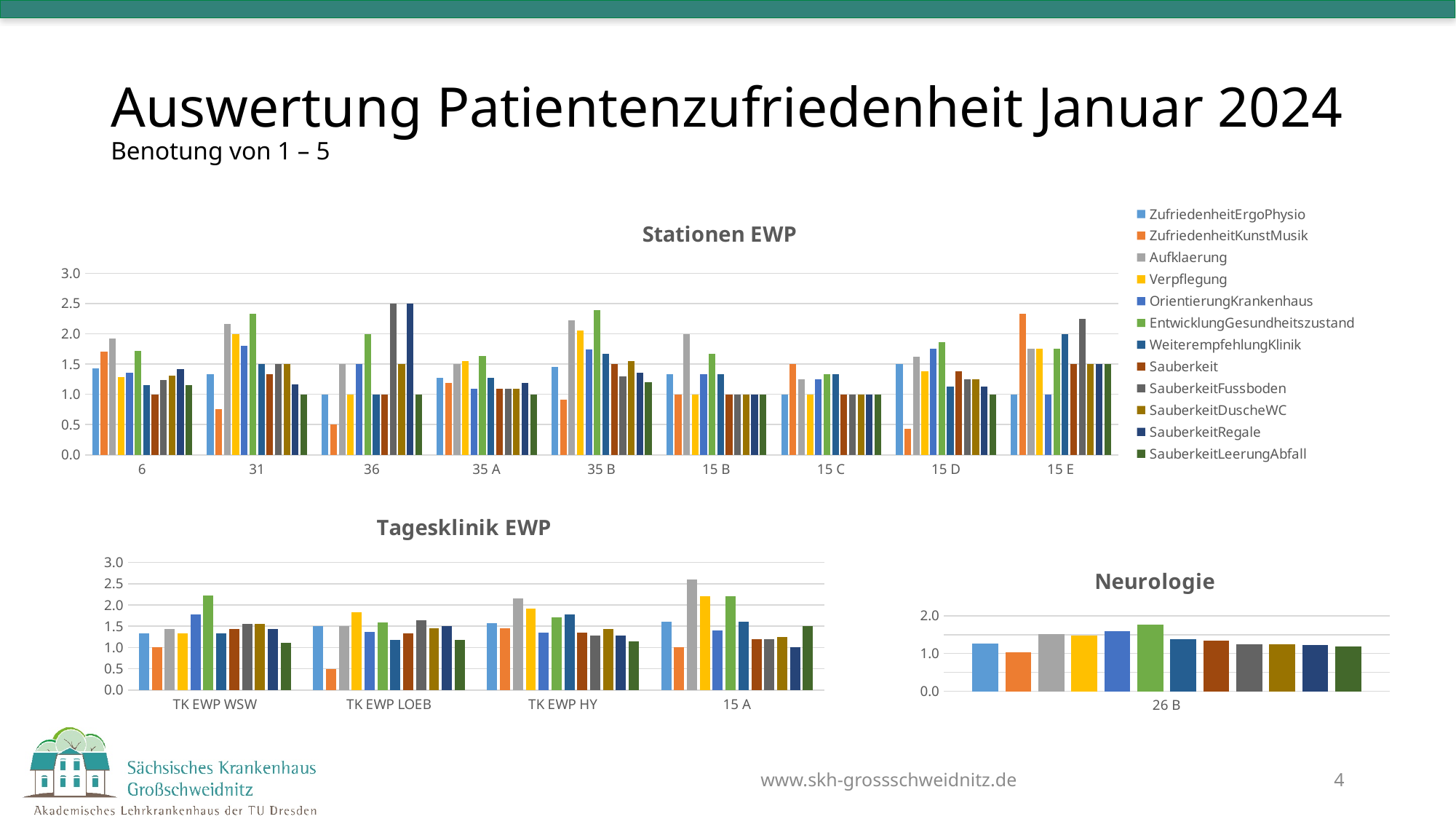
How many categories are shown on the x axis of the 'Stationen EWP' chart? 9 What kind of chart is the 'Stationen EWP' chart? bar chart How many charts are on the slide? 3 How many categories are shown on the x axis of the 'Tagesklinik EWP' chart? 4 In the 'Stationen EWP' chart, for 15 E, which is larger: ZufriedenheitErgoPhysio or ZufriedenheitKunstMusik? ZufriedenheitKunstMusik In the 'Tagesklinik EWP' chart, which category has the highest bar overall? 15 A In the 'Neurologie' chart, which series has the lowest value for 26 B? ZufriedenheitKunstMusik In the 'Stationen EWP' chart, is the value of Aufklaerung for 15 B greater or less than 1.5? greater In the 'Neurologie' chart, which category is shown on the x axis? 26 B In the 'Stationen EWP' chart, is the value of ZufriedenheitKunstMusik for 36 greater or less than 1.0? less In the 'Tagesklinik EWP' chart, is the value of ZufriedenheitKunstMusik for TK EWP LOEB greater or less than 1.0? less How many series does the legend list for the 'Stationen EWP' chart? 12